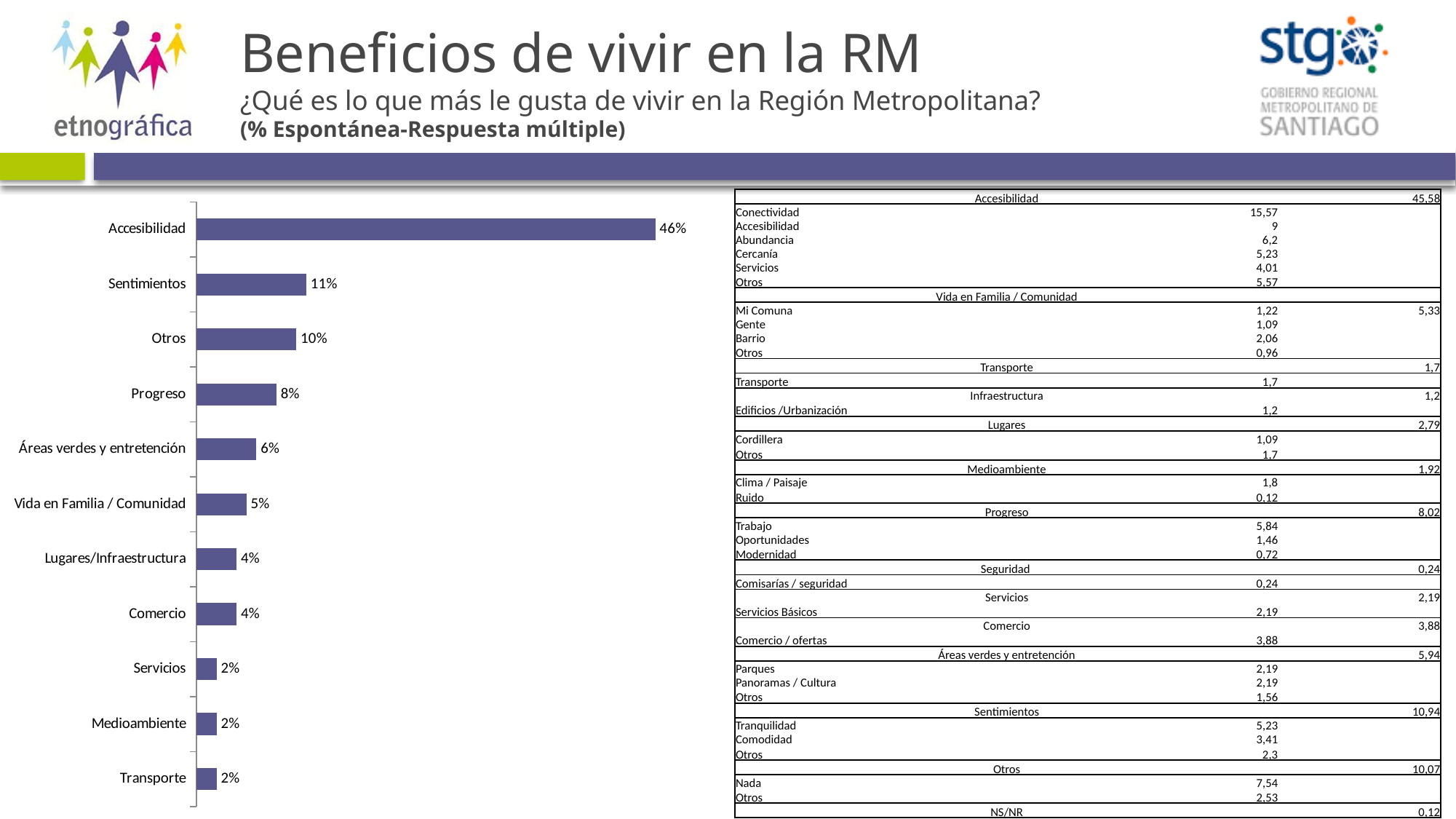
What is the value for Vida en Familia / Comunidad in the bar chart? 5% What is the value for Transporte in the bar chart? 2% What is the value for Áreas verdes y entretención in the bar chart? 6% Which category has the highest value in the bar chart? Accesibilidad Do the bar values decrease or increase going from the top category to the bottom category in the bar chart? Decrease How many categories are shown in the bar chart? 11 What kind of chart is shown on the left of the slide? Bar chart What is the difference between the values for Accesibilidad and Sentimientos in the bar chart? 35 percentage points What is the value for Progreso in the bar chart? 8% Which is larger in the bar chart, the value for Sentimientos or the value for Otros? Sentimientos What is the value for Accesibilidad in the bar chart? 46% What is the value for Sentimientos in the bar chart? 11%